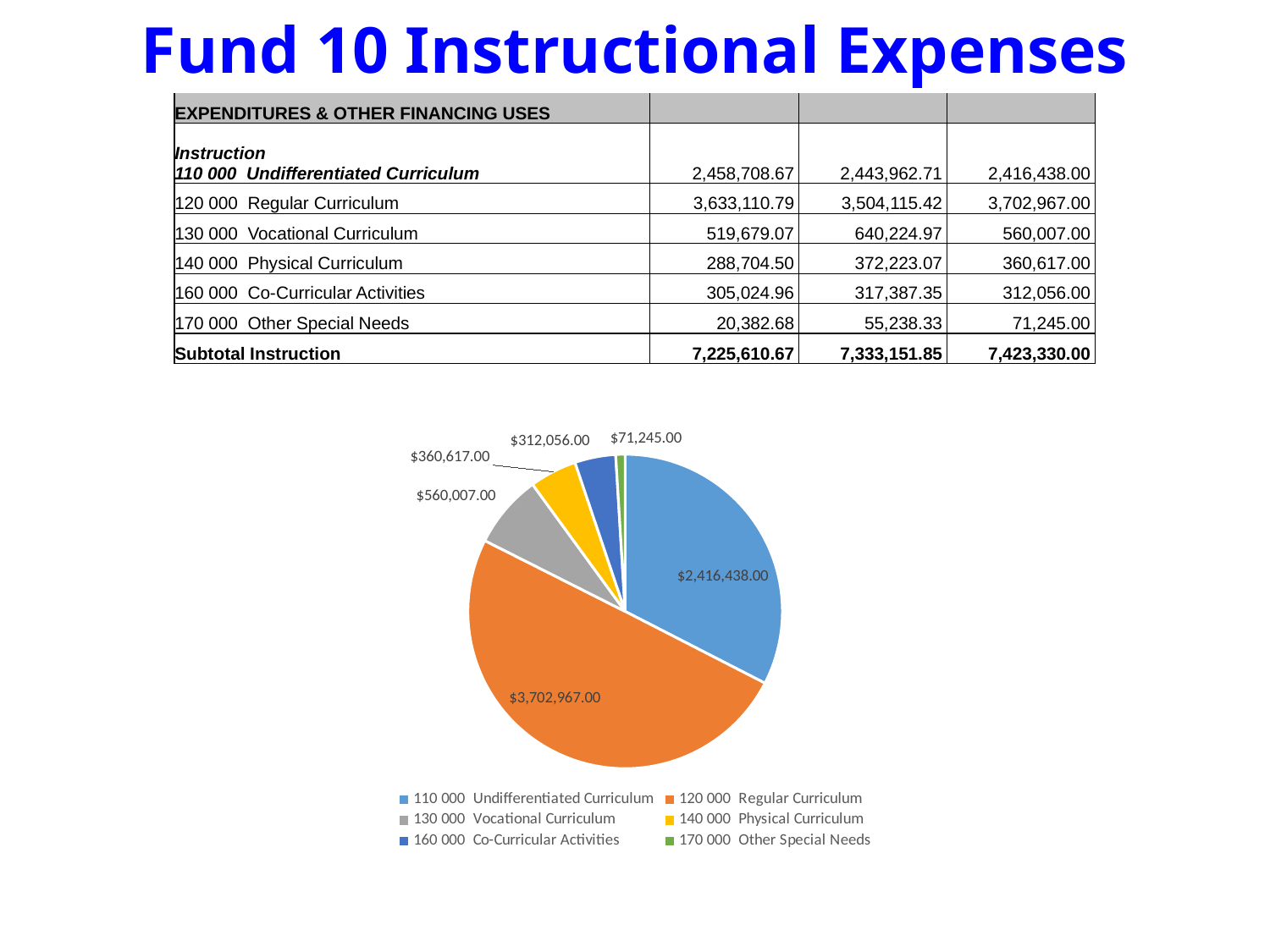
What is the total of all the slices in the pie chart? $7,423,330.00 What type of chart is shown on the slide? Pie chart Which category has the smallest slice in the pie chart? 170 000 Other Special Needs What is the value shown for 120 000 Regular Curriculum in the pie chart? $3,702,967.00 Which is larger in the pie chart: 140 000 Physical Curriculum or 160 000 Co-Curricular Activities? 140 000 Physical Curriculum What is the difference between the values for 120 000 Regular Curriculum and 110 000 Undifferentiated Curriculum in the pie chart? $1,286,529.00 Which category has the largest slice in the pie chart? 120 000 Regular Curriculum What colour is the slice for 130 000 Vocational Curriculum in the pie chart? Gray How many categories does the pie chart legend list? 6 What is the value shown for 110 000 Undifferentiated Curriculum in the pie chart? $2,416,438.00 What is the value shown for 130 000 Vocational Curriculum in the pie chart? $560,007.00 What is the value shown for 170 000 Other Special Needs in the pie chart? $71,245.00